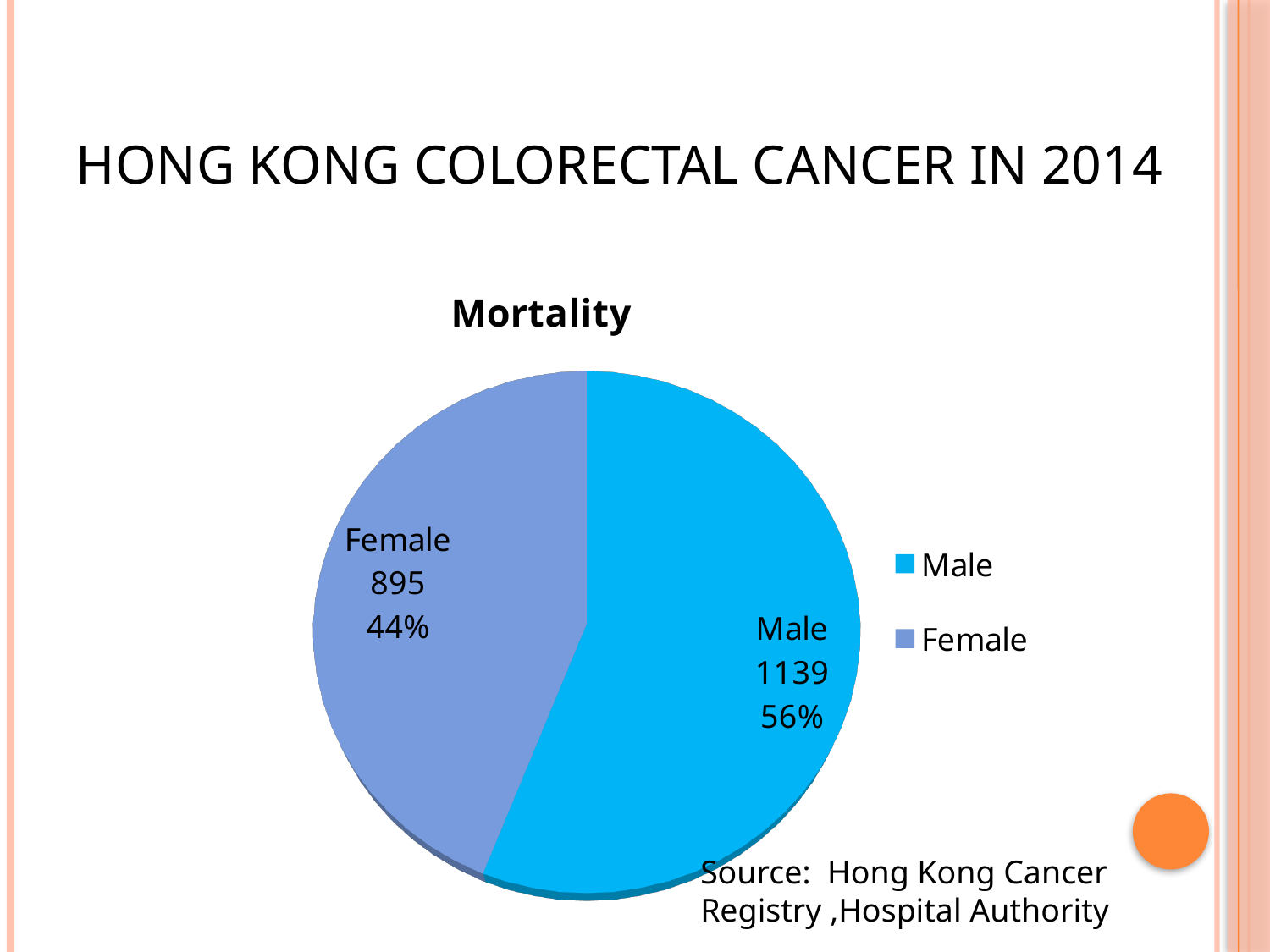
What type of chart is shown on the slide? pie chart Which category has the smallest slice in the pie? Female What is the difference between the Male and Female mortality values? 244 How many categories does the pie chart have? 2 What share of the pie does the Female slice represent? 44% What is the title of the chart? Mortality Which category has the larger slice, Male or Female? Male What share of the pie does the Male slice represent? 56% What is the mortality value for Female? 895 What is the mortality value for Male? 1139 What is the total of the Male and Female mortality values? 2034 How many entries does the legend list? 2